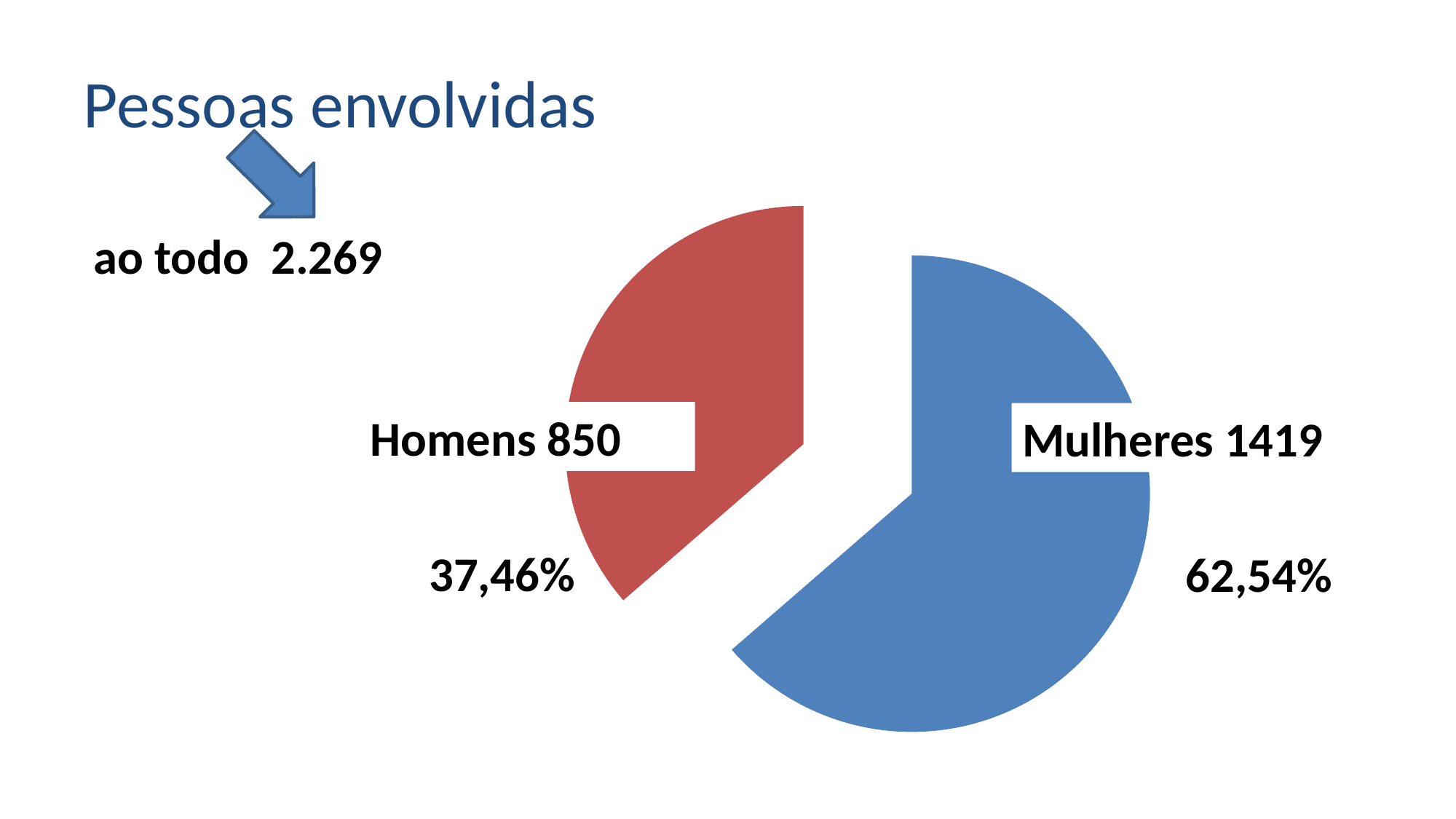
What percentage share does the Homens slice represent? 37,46% What kind of chart is shown on the slide? pie chart What colour is the Mulheres slice? blue Which category has the largest slice? Mulheres Which is larger, the value for Homens or the value for Mulheres? Mulheres Which category has the smallest slice? Homens How many slices does the pie chart have? 2 What is the value for Homens? 850 What percentage share does the Mulheres slice represent? 62,54% What is the value for Mulheres? 1419 What is the difference between the values for Mulheres and Homens? 569 What total number of people is stated on the slide? 2.269